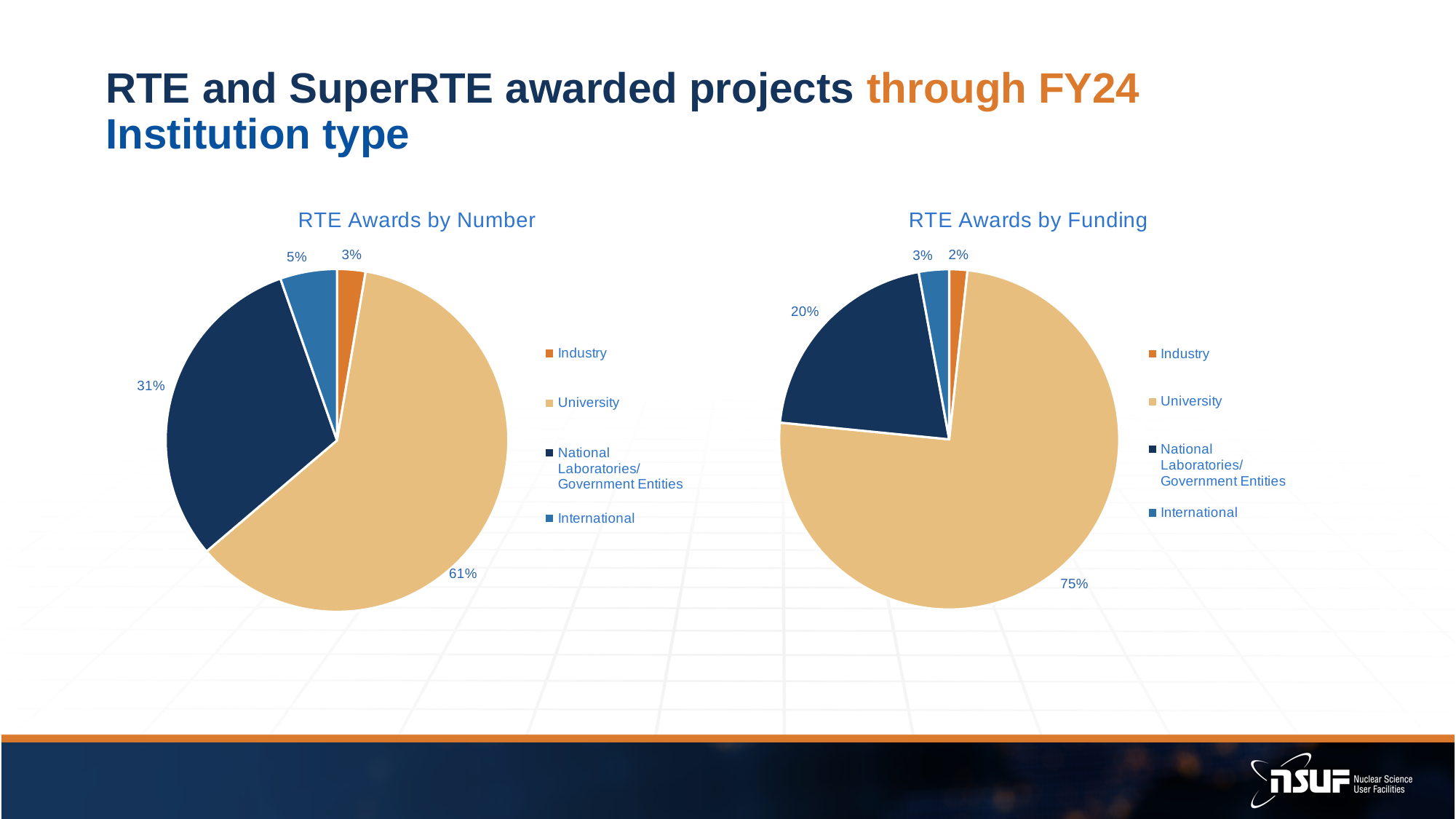
What type of chart is 'RTE Awards by Funding'? Pie chart In the 'RTE Awards by Funding' chart, what share of funding goes to Industry? 2% In the 'RTE Awards by Number' chart, what colour represents National Laboratories/Government Entities? Dark blue In the 'RTE Awards by Number' chart, which is larger: the International slice or the Industry slice? International In the 'RTE Awards by Number' chart, what share of awards goes to National Laboratories/Government Entities? 31% In the 'RTE Awards by Number' chart, what share of awards goes to International? 5% In the 'RTE Awards by Funding' chart, which category has the largest slice? University In the 'RTE Awards by Funding' chart, what is the difference between the University share and the National Laboratories/Government Entities share? 55% How many categories does the legend of the 'RTE Awards by Number' chart list? 4 In the 'RTE Awards by Number' chart, which category has the smallest slice? Industry In the 'RTE Awards by Funding' chart, what share of funding goes to University? 75% In the 'RTE Awards by Number' chart, what share of awards goes to University? 61%